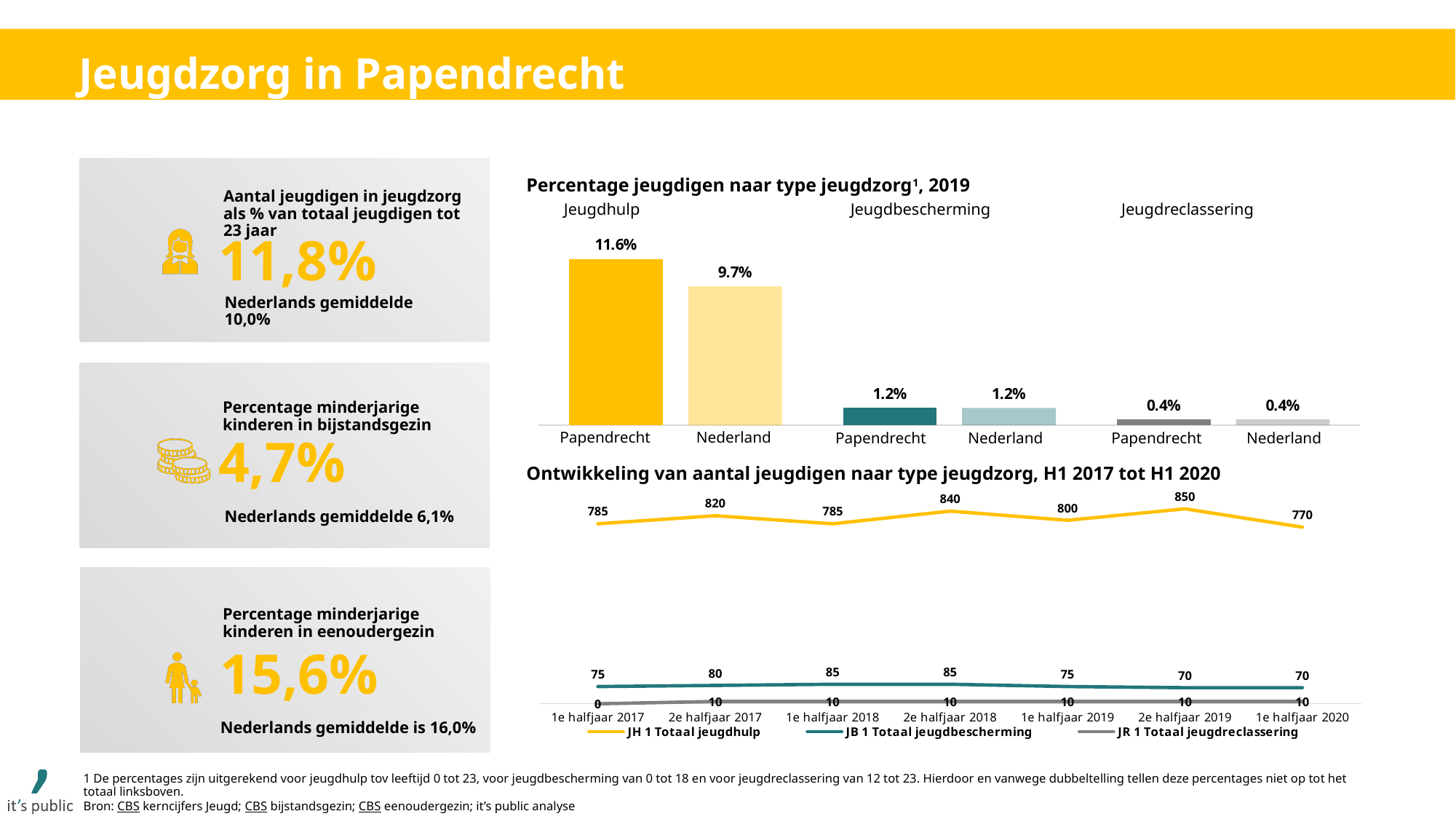
In the chart 'Ontwikkeling van aantal jeugdigen naar type jeugdzorg, H1 2017 tot H1 2020', what is the difference between JH 1 Totaal jeugdhulp in 2e halfjaar 2019 and 1e halfjaar 2020? 80 In the chart 'Ontwikkeling van aantal jeugdigen naar type jeugdzorg, H1 2017 tot H1 2020', what is the value of JH 1 Totaal jeugdhulp in 2e halfjaar 2019? 850 What kind of chart is 'Percentage jeugdigen naar type jeugdzorg, 2019'? Bar chart In the chart 'Percentage jeugdigen naar type jeugdzorg, 2019', what is the difference between the Jeugdhulp values for Papendrecht and Nederland? 1.9% How many series does the legend of the chart 'Ontwikkeling van aantal jeugdigen naar type jeugdzorg, H1 2017 tot H1 2020' list? 3 In the chart 'Ontwikkeling van aantal jeugdigen naar type jeugdzorg, H1 2017 tot H1 2020', in which period is JH 1 Totaal jeugdhulp lowest? 1e halfjaar 2020 In the chart 'Percentage jeugdigen naar type jeugdzorg, 2019', what is the Jeugdreclassering value for Papendrecht? 0.4% In the chart 'Ontwikkeling van aantal jeugdigen naar type jeugdzorg, H1 2017 tot H1 2020', what is the value of JB 1 Totaal jeugdbescherming in 1e halfjaar 2018? 85 How many time periods are shown on the x axis of the chart 'Ontwikkeling van aantal jeugdigen naar type jeugdzorg, H1 2017 tot H1 2020'? 7 In the chart 'Percentage jeugdigen naar type jeugdzorg, 2019', what is the Jeugdhulp value for Nederland? 9.7% In the chart 'Percentage jeugdigen naar type jeugdzorg, 2019', which bar is the highest? Jeugdhulp Papendrecht In the chart 'Percentage jeugdigen naar type jeugdzorg, 2019', what is the Jeugdhulp value for Papendrecht? 11.6%